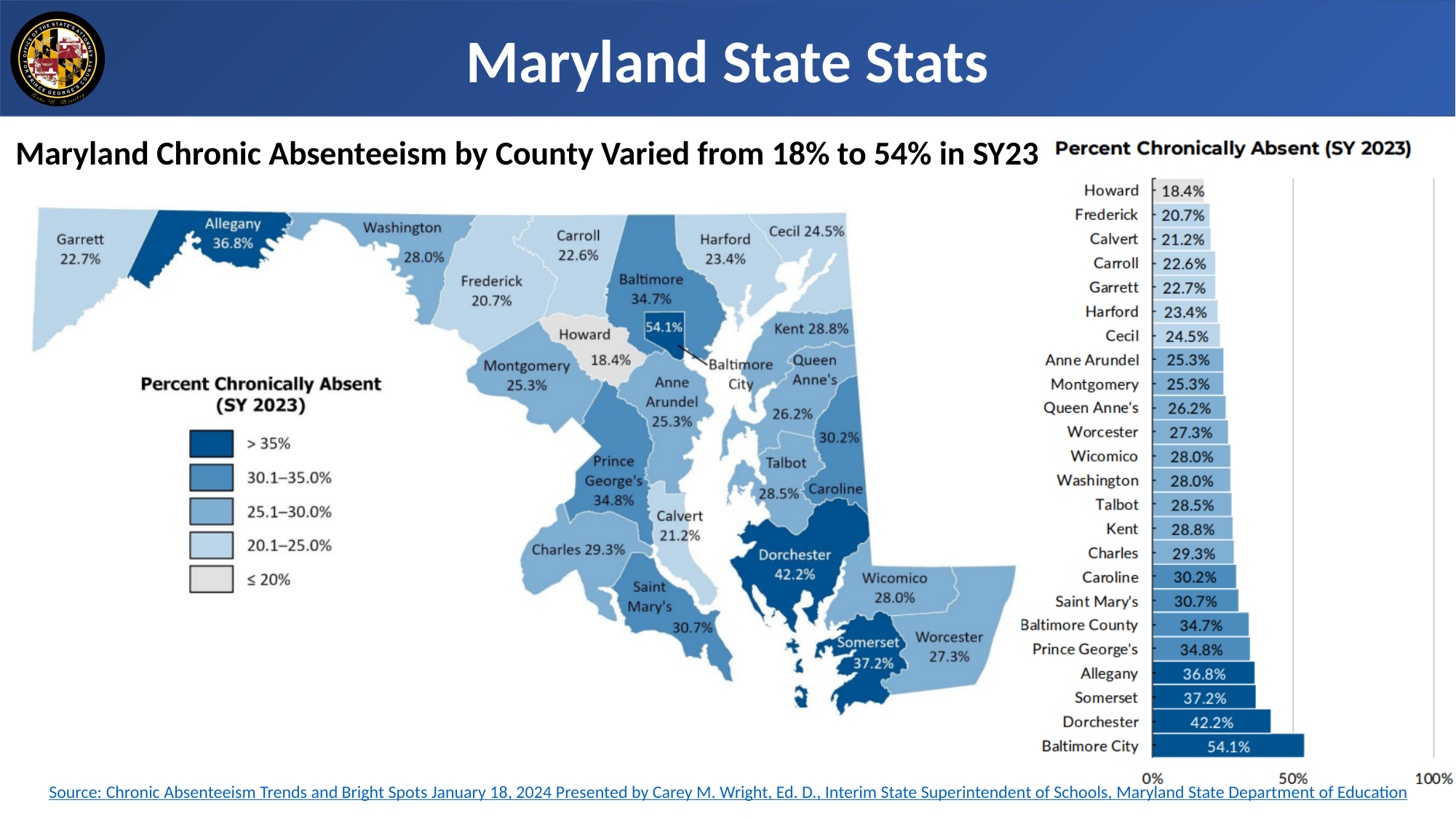
In the bar chart on the right, what is the difference between the percent chronically absent for Baltimore City and Dorchester? 11.9% In the bar chart on the right, which has a higher percent chronically absent, Somerset or Allegany? Somerset In the bar chart on the right, what is the percent chronically absent for Prince George's? 34.8% What is the title of the bar chart on the right? Percent Chronically Absent (SY 2023) In the bar chart on the right, is the value for Baltimore City greater or less than 50%? greater What kind of chart is the chart on the right side of the slide? Bar chart On the map, what is the percent chronically absent shown for Dorchester? 42.2% In the bar chart on the right, what is the percent chronically absent for Howard? 18.4% How many counties are listed in the bar chart on the right? 24 In the bar chart on the right, which county has the highest percent chronically absent? Baltimore City In the bar chart on the right, what is the percent chronically absent for Baltimore City? 54.1% In the bar chart on the right, which county has the lowest percent chronically absent? Howard